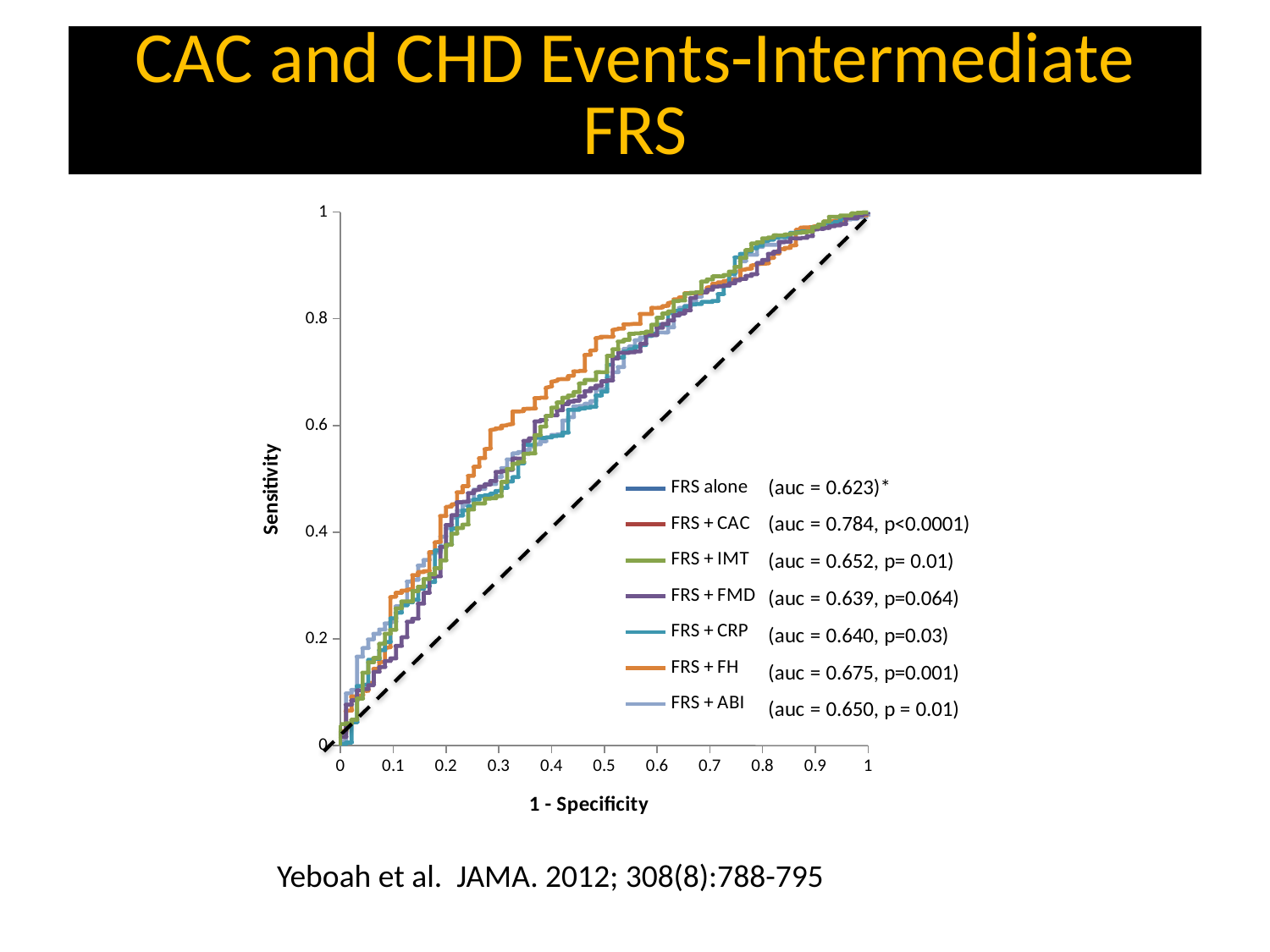
What is the AUC value given for FRS + FH? 0.675 Which has a larger AUC, FRS + FH or FRS + IMT? FRS + FH How many series does the legend list? 7 What is the AUC value given for FRS alone? 0.623 What p-value is given for FRS + CRP? p=0.03 What kind of chart is shown on the slide? line chart Which series has the lowest AUC value? FRS alone What is the difference between the AUC of FRS + CAC and the AUC of FRS alone? 0.161 What is the label on the vertical axis? Sensitivity What is the label on the horizontal axis? 1 - Specificity What is the AUC value given for FRS + CAC? 0.784 Which series has the highest AUC value? FRS + CAC